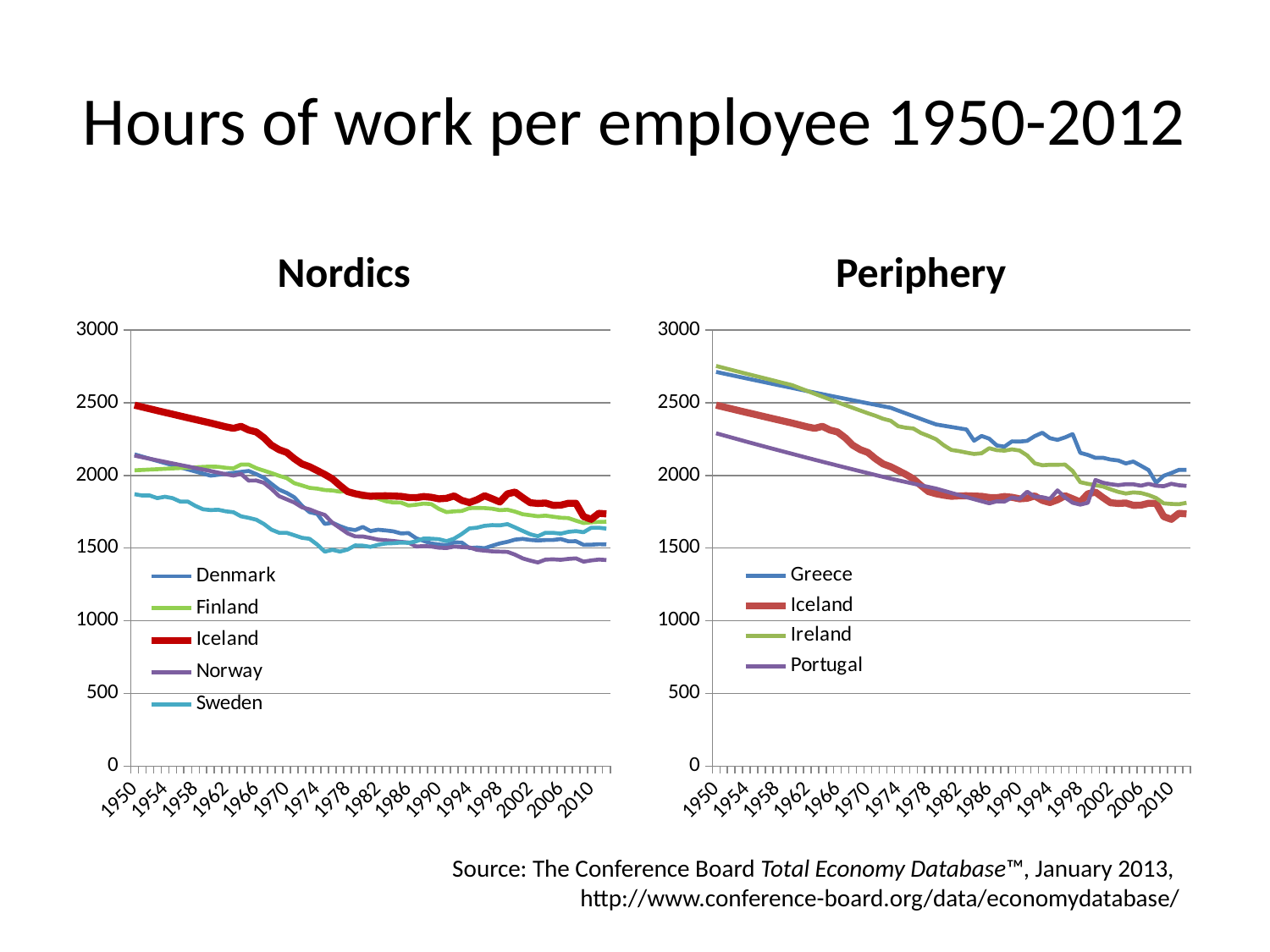
In the Nordics chart, which country has the lowest hours of work per employee in 1950? Sweden How many series does the legend of the Periphery chart list? 4 What kind of chart is the Nordics chart? line chart In the Nordics chart, which country has the highest hours of work per employee in 1950? Iceland In the Periphery chart, do the hours of work per employee for Ireland rise or fall from 1950 to 2010? fall In the Periphery chart, which country has the lowest hours of work per employee in 1950? Portugal Which country appears in the legends of both the Nordics and Periphery charts? Iceland How many series does the legend of the Nordics chart list? 5 In the Nordics chart, which country has the lowest hours of work per employee in 2010? Norway In the Periphery chart, is the value for Greece in 1950 greater or less than 2500? greater In the Nordics chart, is the value for Norway in 2010 greater or less than 1500? less